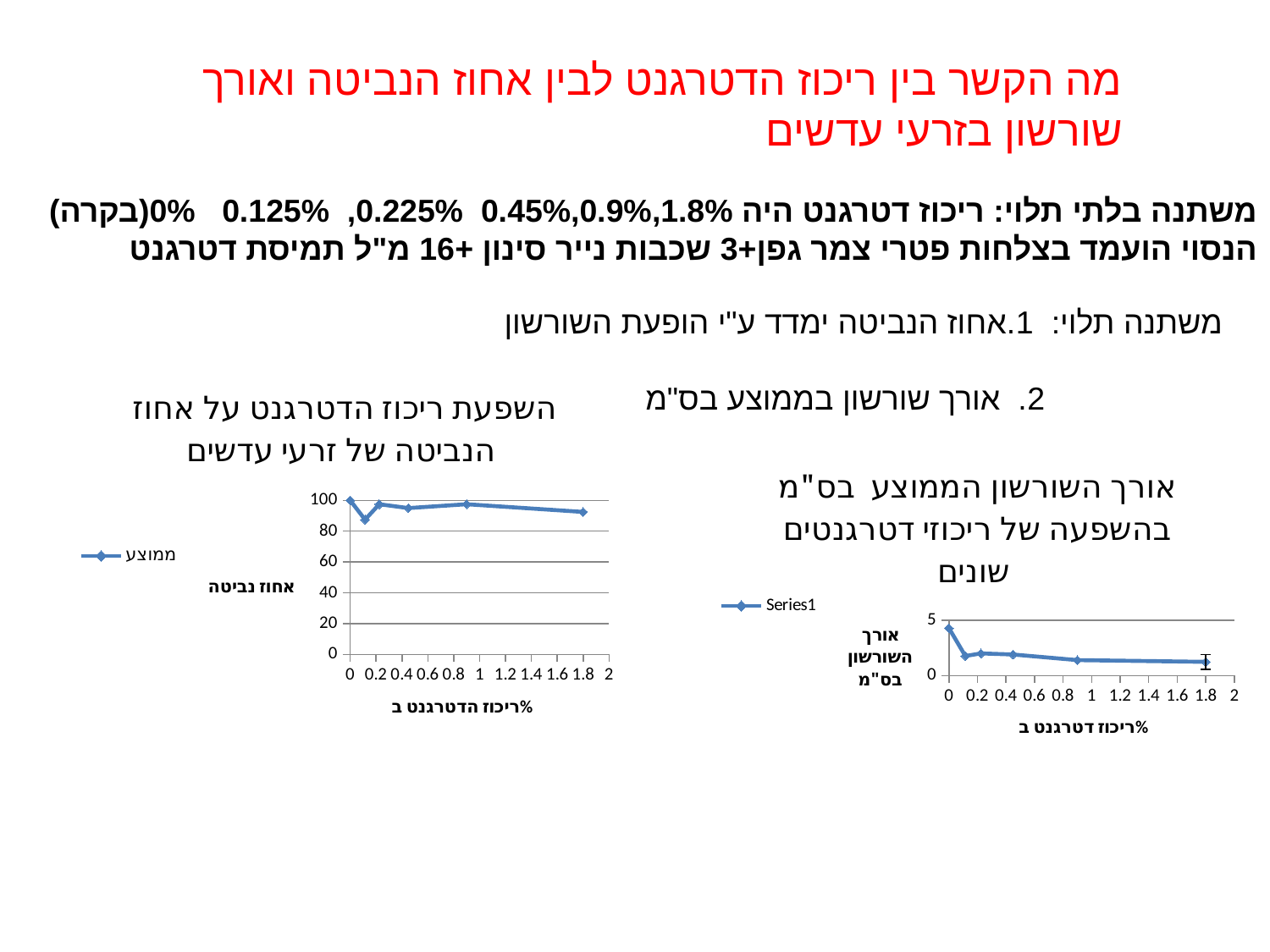
In the right chart (root length), at which detergent concentration is the average root length highest? 0 In the right chart (root length), what is the legend entry for the plotted series? Series1 In the right chart (root length), does the average root length generally rise or fall as detergent concentration increases? fall In the left chart (germination percentage), how many data points are plotted? 6 In the left chart (germination percentage), is the value at detergent concentration 1.8 greater or less than 80? greater In the left chart (germination percentage), how many series does the legend list? 1 In the right chart (root length), how many data points are plotted? 6 What kind of chart is the right chart, titled 'אורך השורשון הממוצע בס"מ בהשפעה של ריכוזי דטרגנטים שונים'? line chart In the right chart (root length), is the value at detergent concentration 0 greater or less than 3? greater What kind of chart is the left chart, titled 'השפעת ריכוז הדטרגנט על אחוז הנביטה של זרעי עדשים'? line chart In the left chart (germination percentage), at which detergent concentration is the germination percentage highest? 0 In the right chart (root length), is the value at detergent concentration 1.8 greater or less than 3? less